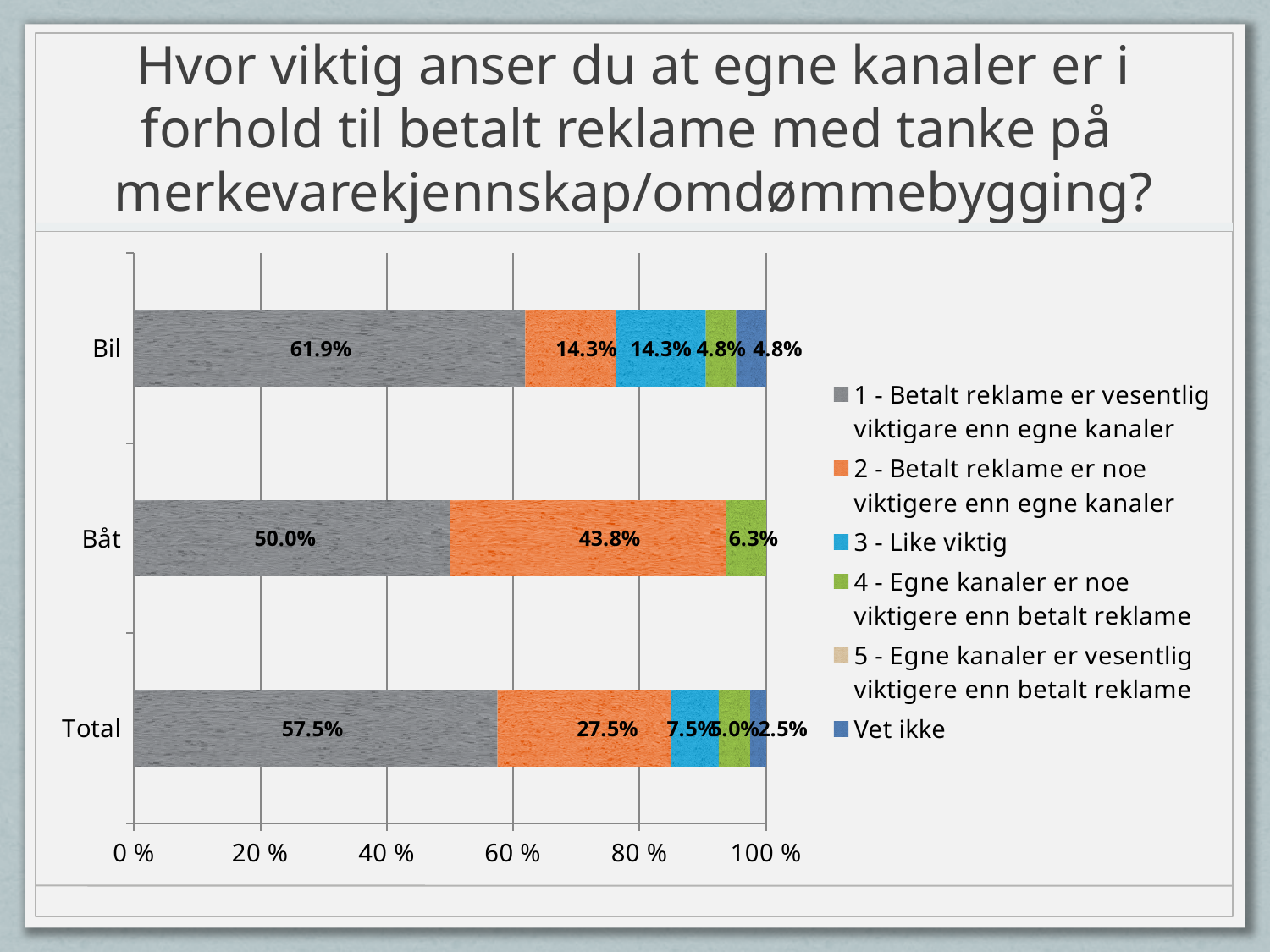
How many categories are shown on the vertical axis of the chart? 3 What kind of chart is shown on the slide? stacked bar chart What is the difference between the '1 - Betalt reklame er vesentlig viktigare enn egne kanaler' values for Bil and Båt? 11.9% Is the '2 - Betalt reklame er noe viktigere enn egne kanaler' value larger for Båt or for Total? Båt Which category has the lowest value for '2 - Betalt reklame er noe viktigere enn egne kanaler'? Bil Which category has the highest value for '1 - Betalt reklame er vesentlig viktigare enn egne kanaler'? Bil What is the value of '3 - Like viktig' for Total? 7.5% What is the value of '1 - Betalt reklame er vesentlig viktigare enn egne kanaler' for Bil? 61.9% What is the value of '2 - Betalt reklame er noe viktigere enn egne kanaler' for Båt? 43.8% What is the value of '4 - Egne kanaler er noe viktigere enn betalt reklame' for Båt? 6.3% Which legend entry is shown in orange? 2 - Betalt reklame er noe viktigere enn egne kanaler How many series does the legend list? 6